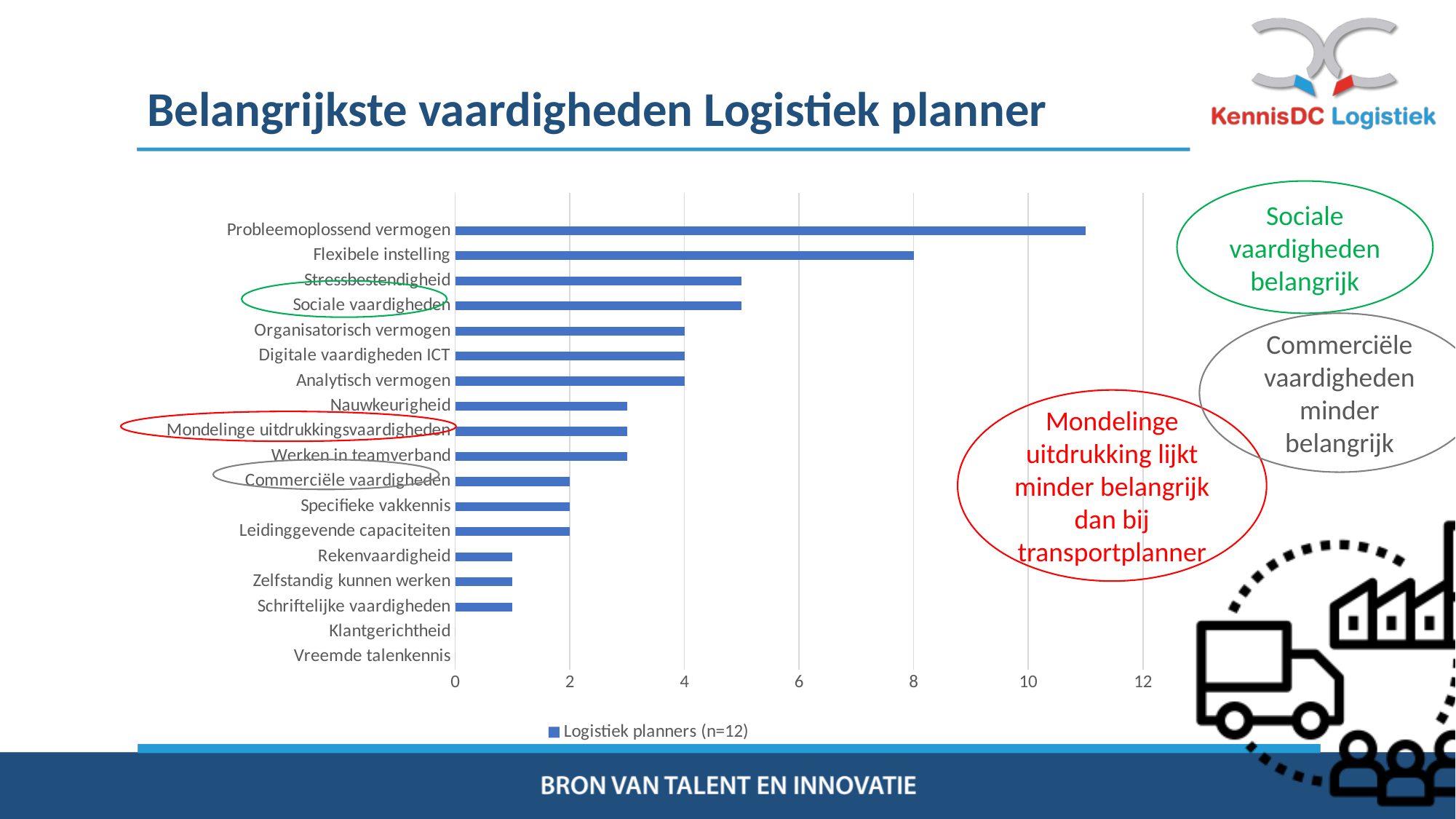
What is the difference between the values for Flexibele instelling and Organisatorisch vermogen? 4 Which skill has the highest value in the chart? Probleemoplossend vermogen What type of chart is shown on the slide? Bar chart What is the value for Organisatorisch vermogen? 4 Which is larger, the value for Flexibele instelling or the value for Leidinggevende capaciteiten? Flexibele instelling How many skill categories are listed on the chart's vertical axis? 18 Is the value for Probleemoplossend vermogen greater or less than 10? greater What is the value for Flexibele instelling? 8 Is the value for Rekenvaardigheid greater or less than 2? less What is the value for Commerciële vaardigheden? 2 What is the legend entry of the chart? Logistiek planners (n=12) Is the value for Stressbestendigheid greater or less than 4? greater